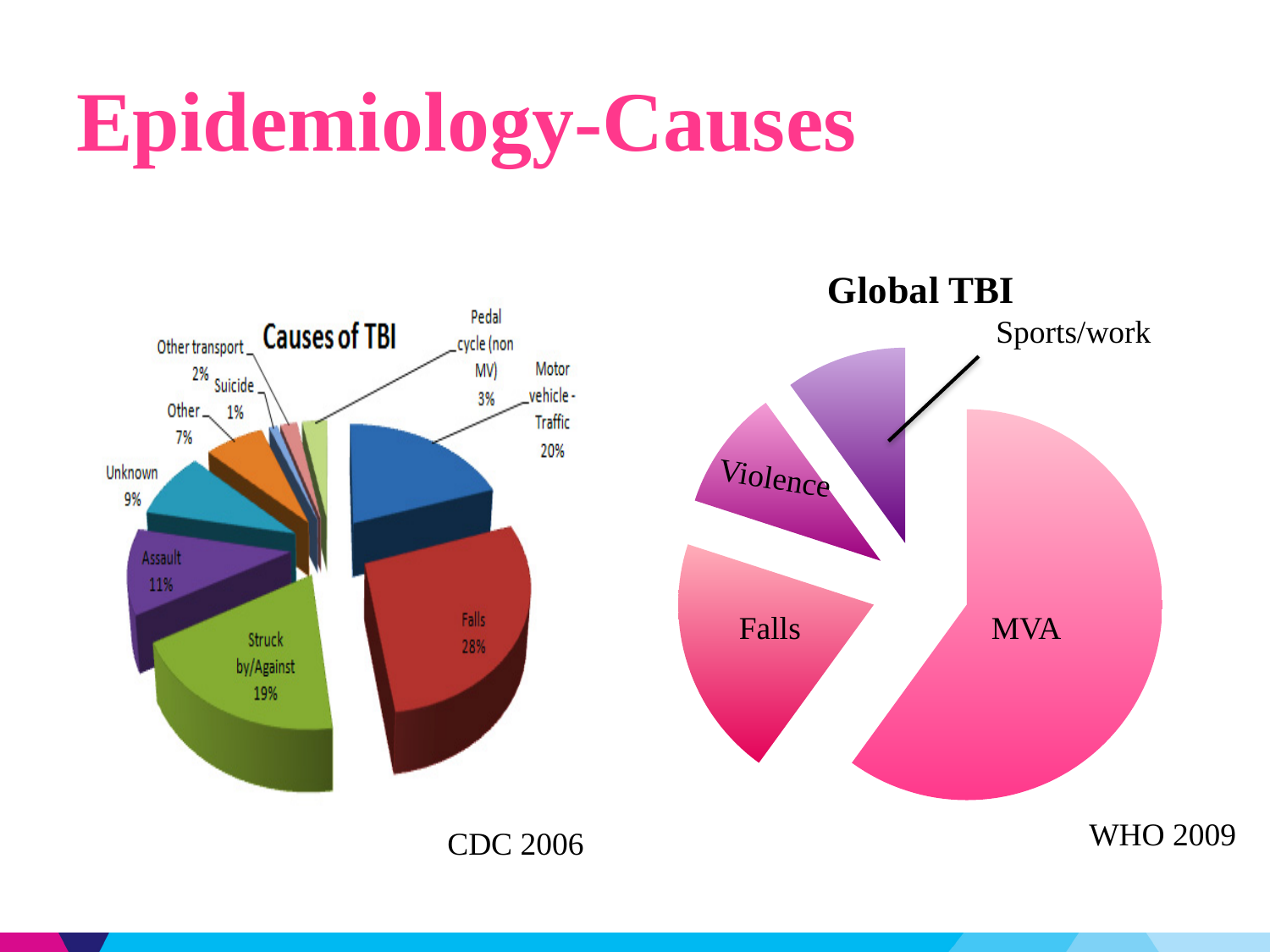
In the 'Causes of TBI' chart, what percentage is attributed to Falls? 28% In the 'Causes of TBI' chart, which cause has the smallest share? Suicide In the 'Causes of TBI' chart, what percentage is attributed to Motor vehicle - Traffic? 20% In the 'Global TBI' chart, which category has the largest slice? MVA In the 'Causes of TBI' chart, what percentage is attributed to Assault? 11% In the 'Causes of TBI' chart, which cause has the largest share? Falls What kind of chart is the 'Global TBI' chart? Pie chart In the 'Causes of TBI' chart, what is the difference between the Falls share and the Struck by/Against share? 9% How many slices are shown in the 'Global TBI' chart? 4 In the 'Causes of TBI' chart, which is larger: Unknown or Other? Unknown In the 'Causes of TBI' chart, what percentage is attributed to Pedal cycle (non MV)? 3% How many categories are shown in the 'Causes of TBI' chart? 9